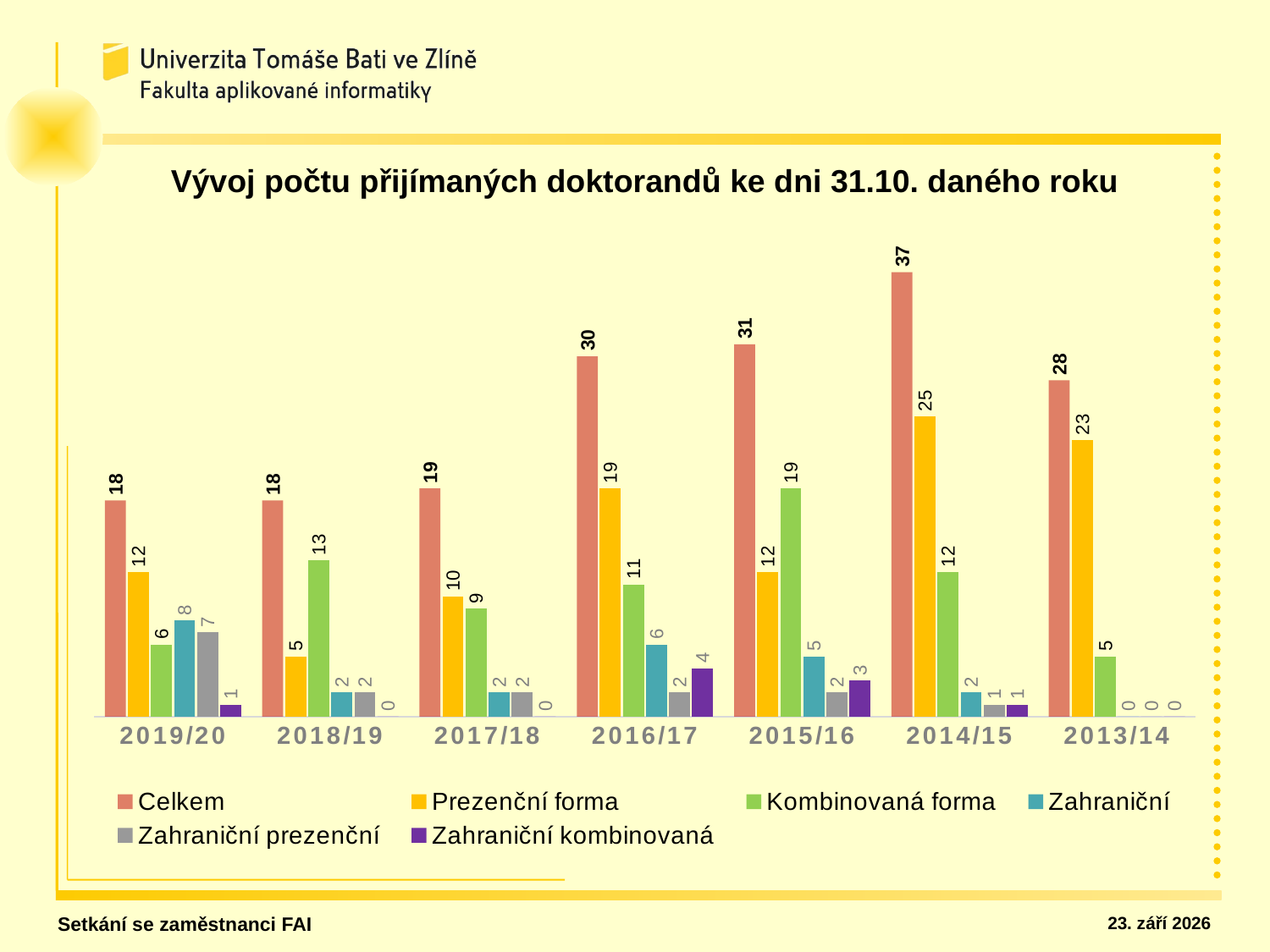
What kind of chart is shown on the slide? Bar chart What is the difference between the Celkem values for 2014/15 and 2013/14? 9 How many series does the legend list? 6 Which is larger for 2018/19: Prezenční forma or Kombinovaná forma? Kombinovaná forma What is the value of Kombinovaná forma for 2015/16? 19 Which year has the highest Celkem value? 2014/15 What is the title of the chart? Vývoj počtu přijímaných doktorandů ke dni 31.10. daného roku How many years are shown on the x axis? 7 Which year has the lowest Kombinovaná forma value? 2013/14 What is the value of Prezenční forma for 2013/14? 23 What is the value of Zahraniční for 2019/20? 8 What is the value of Celkem for 2014/15? 37